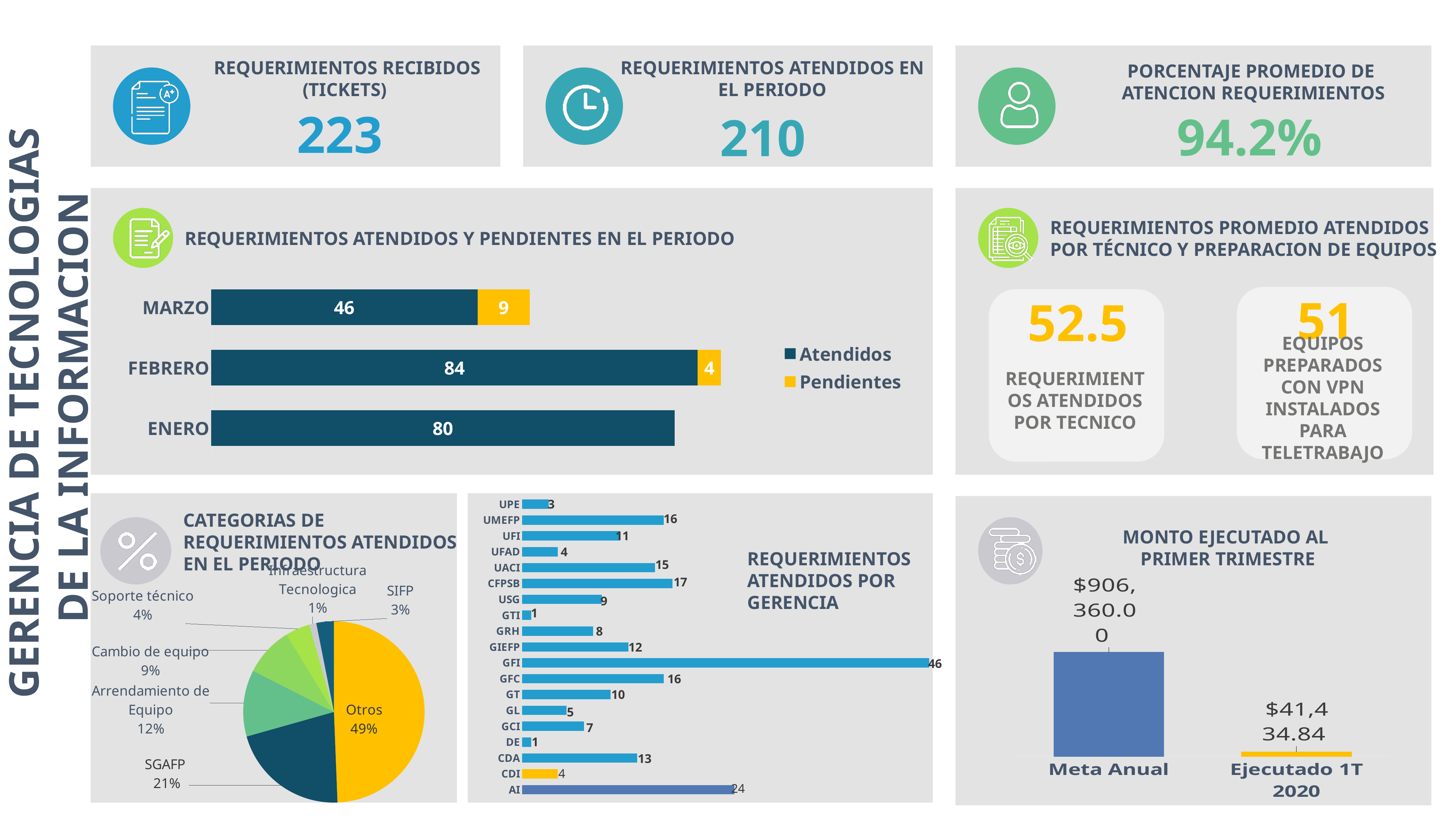
In the chart 'REQUERIMIENTOS ATENDIDOS POR GERENCIA', what is the difference between the values for CFPSB and UACI? 2 In the chart 'REQUERIMIENTOS ATENDIDOS Y PENDIENTES EN EL PERIODO', what is the Atendidos value for FEBRERO? 84 In the pie chart 'CATEGORIAS DE REQUERIMIENTOS ATENDIDOS EN EL PERIODO', which category has the smallest slice? Infraestructura Tecnologica In the pie chart 'CATEGORIAS DE REQUERIMIENTOS ATENDIDOS EN EL PERIODO', what share does SGAFP have? 21% What kind of chart is 'MONTO EJECUTADO AL PRIMER TRIMESTRE'? Bar chart In the chart 'REQUERIMIENTOS ATENDIDOS POR GERENCIA', which is larger, the value for CDA or the value for GT? CDA In the pie chart 'CATEGORIAS DE REQUERIMIENTOS ATENDIDOS EN EL PERIODO', which category has the largest slice? Otros In the chart 'REQUERIMIENTOS ATENDIDOS Y PENDIENTES EN EL PERIODO', which month has the highest Atendidos value? FEBRERO In the chart 'REQUERIMIENTOS ATENDIDOS POR GERENCIA', what is the value for GFI? 46 In the chart 'REQUERIMIENTOS ATENDIDOS Y PENDIENTES EN EL PERIODO', what is the Pendientes value for MARZO? 9 In the chart 'REQUERIMIENTOS ATENDIDOS Y PENDIENTES EN EL PERIODO', how many series does the legend list? 2 In the chart 'REQUERIMIENTOS ATENDIDOS Y PENDIENTES EN EL PERIODO', what is the total of the MARZO bar (Atendidos plus Pendientes)? 55